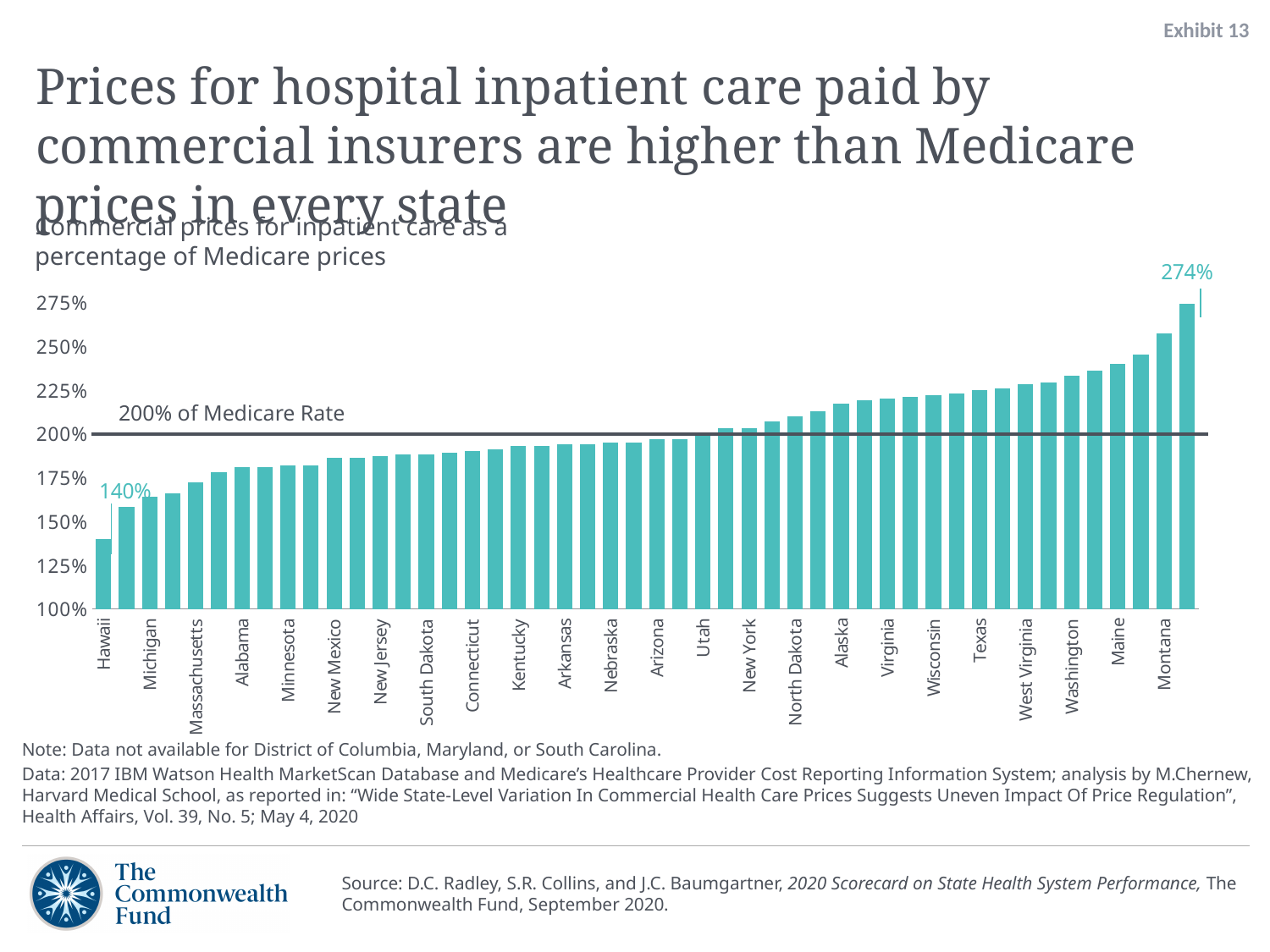
Is the value for Texas greater or less than 200%? greater What is the value shown for Hawaii? 140% Is the value for Michigan greater or less than 175%? less What kind of chart is shown on the slide? Bar chart What level does the horizontal reference line on the chart mark? 200% of Medicare Rate Is the value for Washington greater or less than 250%? less Which state has the lowest commercial price as a percentage of Medicare prices? Hawaii Do the values rise or fall moving from left to right across the states? Rise Which is larger, the value for Hawaii or the value for Montana? Montana